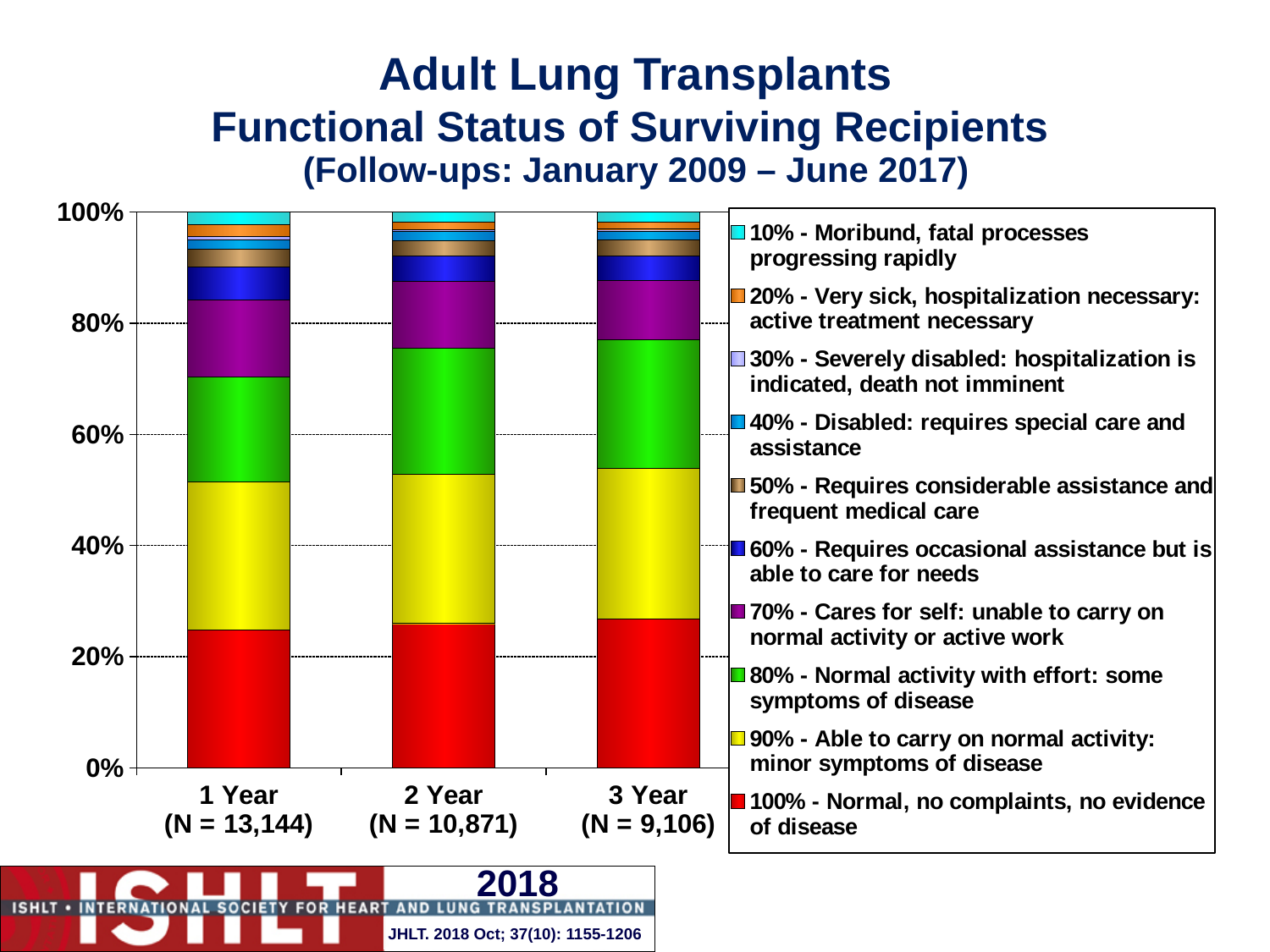
At 1 Year, which segment is larger: 90% functional status (yellow) or 80% functional status (green)? 90% functional status (yellow) Is the share of recipients with 80% functional status (green segment) at 3 Year greater or less than 20%? greater Is the share of recipients with 100% functional status (red segment) at 1 Year greater or less than 20%? greater At 3 Year, which segment is larger: 100% functional status (red) or 70% functional status (purple)? 100% functional status (red) Is the share of recipients with 10% functional status (light blue segment) at 2 Year greater or less than 20%? less What kind of chart is shown on the slide? stacked bar chart What is the N shown for the 1 Year follow-up? 13,144 What does each stacked bar total? 100% How many follow-up time points (categories) are plotted on the x axis? 3 How many functional status categories does the legend list? 10 What follow-up period does the chart subtitle give? January 2009 – June 2017